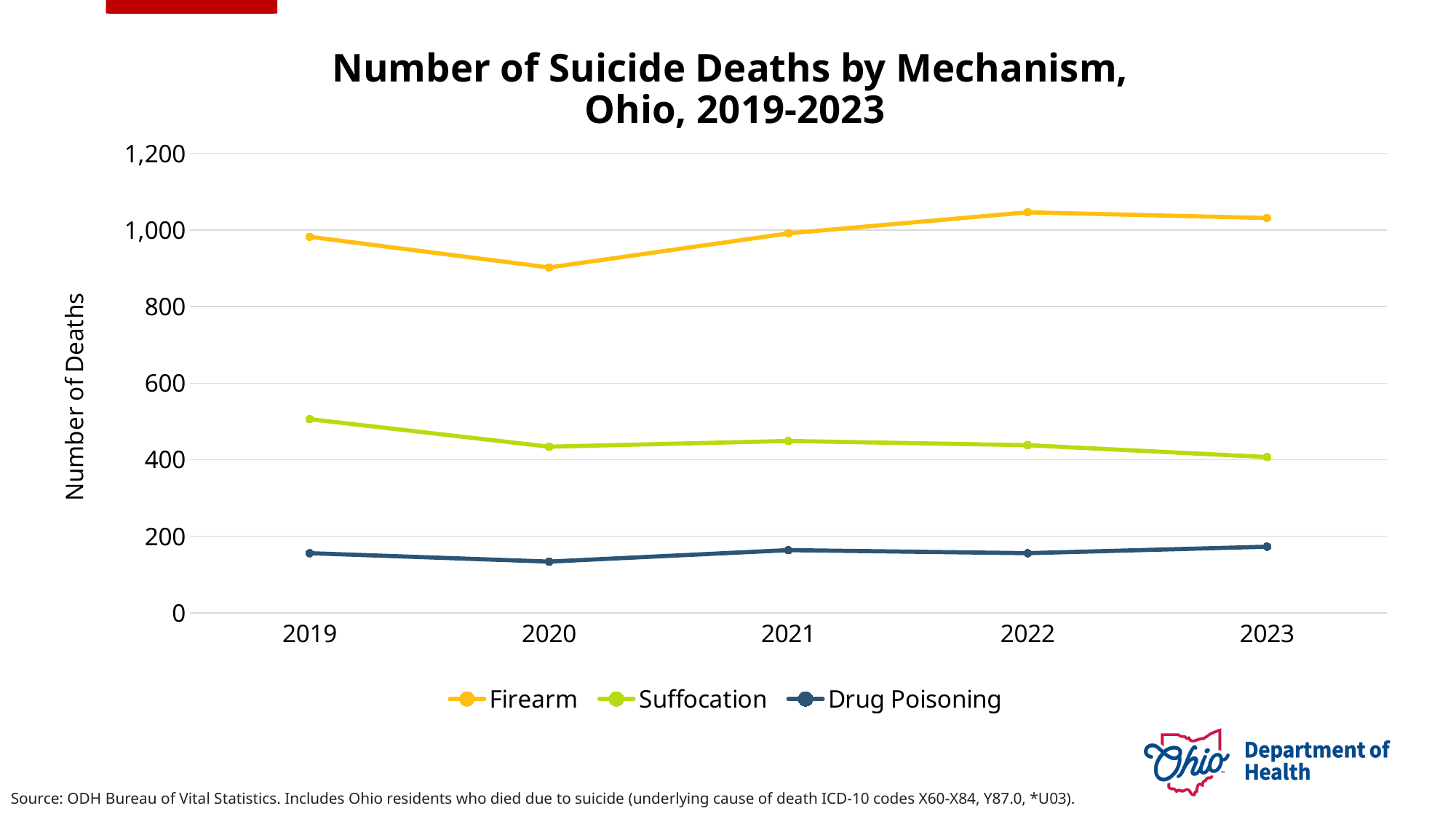
Which mechanism has the highest number of deaths in every year shown? Firearm What kind of chart is shown on the slide? line chart How many series does the legend list? 3 Is the value for Suffocation in 2019 greater or less than 600? less Is the value for Firearm in 2022 greater or less than 1,000? greater Did the number of Suffocation deaths rise or fall from 2019 to 2023? fall In which year was the number of Suffocation suicide deaths highest? 2019 In which year was the number of Firearm suicide deaths lowest? 2020 How many years are plotted along the x axis? 5 Is the value for Drug Poisoning in 2023 greater or less than 200? less Which mechanism has the lowest number of deaths in every year shown? Drug Poisoning